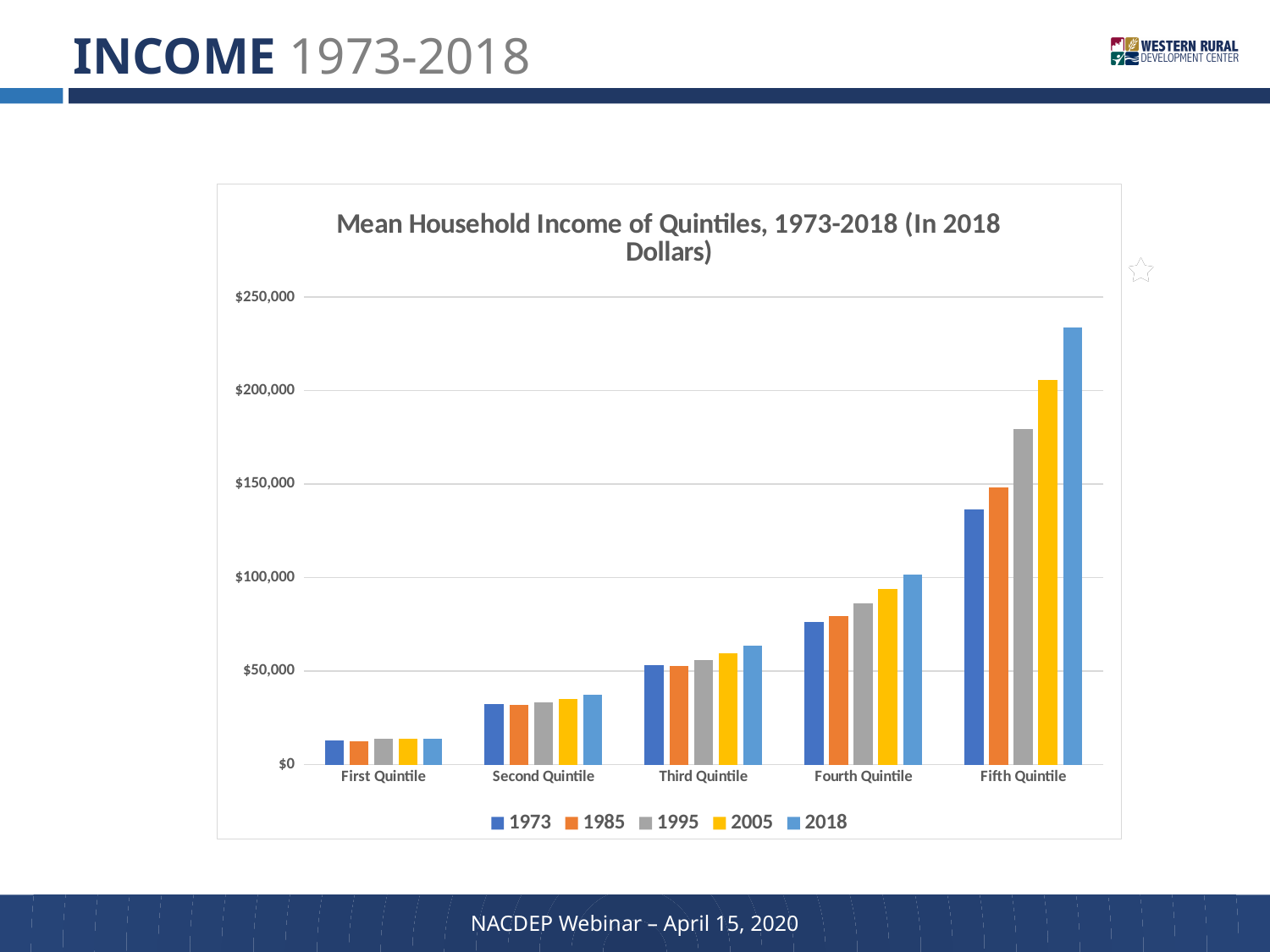
Is the 2018 value for the Fifth Quintile greater or less than $200,000? greater Is the 1973 value for the Fifth Quintile greater or less than $150,000? less What is the title of the chart? Mean Household Income of Quintiles, 1973-2018 (In 2018 Dollars) How many series does the legend list? 5 Which is larger, the 2018 value for the Fourth Quintile or the 2018 value for the Fifth Quintile? Fifth Quintile Which quintile has the lowest mean household income in 2018? First Quintile Within the Fifth Quintile, do the values rise or fall from 1973 to 2018? rise Is the 2018 value for the Third Quintile greater or less than $50,000? greater Which quintile has the highest mean household income in 2018? Fifth Quintile What kind of chart is shown on the slide? bar chart How many quintile categories are shown on the x axis? 5